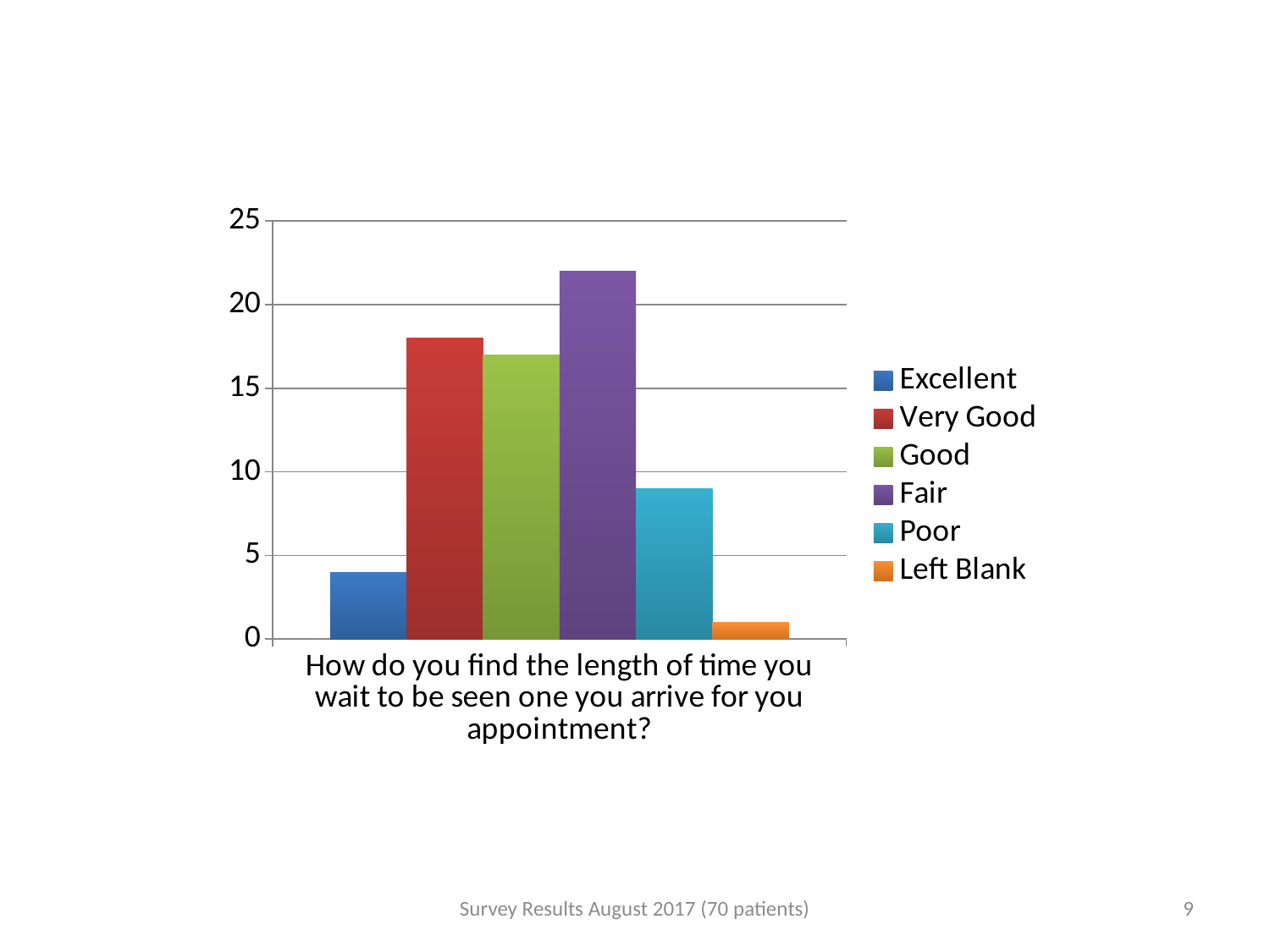
Which is larger, the value for Excellent or the value for Very Good? Very Good Is the value for Excellent greater or less than 5? less What kind of chart is shown on the slide? bar chart Is the value for Very Good greater or less than 15? greater Which response option has the lowest bar? Left Blank Which response option has the highest bar? Fair Is the value for Poor greater or less than 10? less Which is larger, the value for Fair or the value for Poor? Fair What colour is the bar for Poor? teal/light blue How many series does the legend list? 6